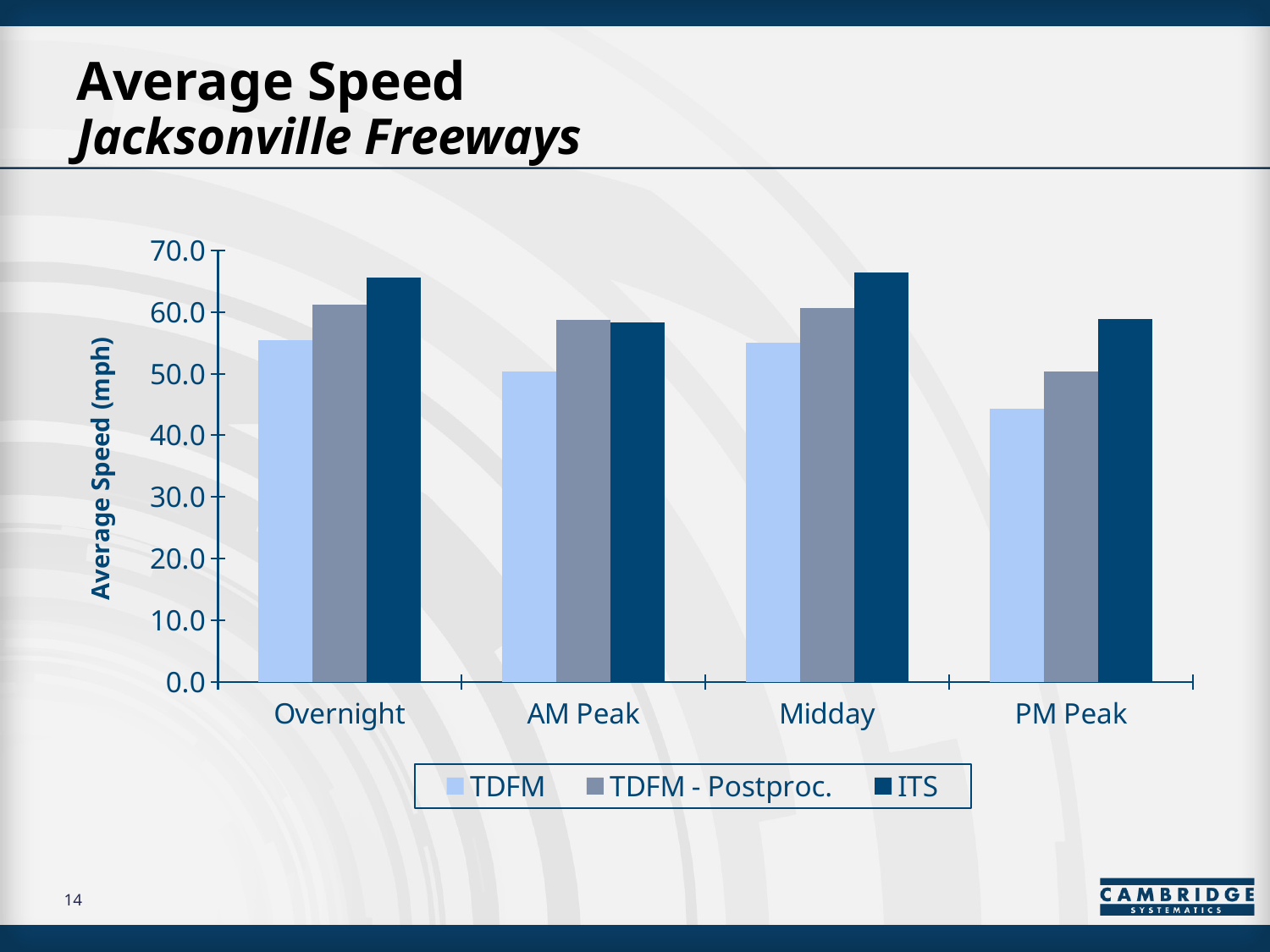
What is the label of the y axis? Average Speed (mph) For Overnight, which is larger: the TDFM value or the ITS value? ITS How many series does the legend list? 3 For PM Peak, which is larger: the TDFM value or the ITS value? ITS For which time period is the TDFM value lowest? PM Peak Which series is shown in the darkest blue bars? ITS What kind of chart is shown on the slide? bar chart Is the TDFM value for PM Peak greater or less than 50.0? less Is the ITS value for Overnight greater or less than 60.0? greater Is the ITS value for Midday greater or less than 60.0? greater How many time periods are shown on the x axis? 4 For which time period is the TDFM - Postproc. value lowest? PM Peak